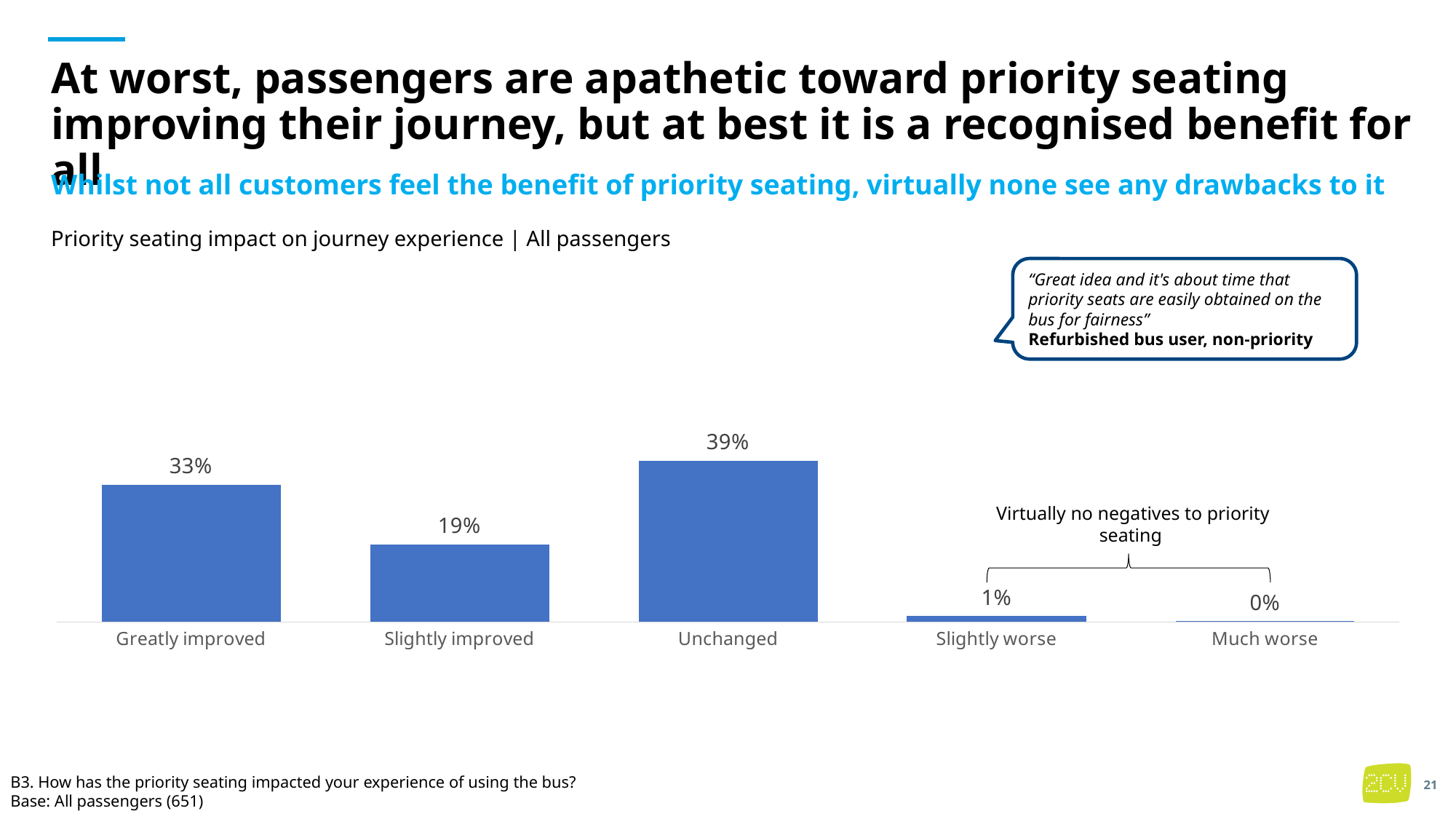
What is the combined value of Greatly improved and Slightly improved? 52% What percentage of passengers said their journey experience was greatly improved by priority seating? 33% What is the value for Slightly worse? 1% Which is larger, Greatly improved or Slightly improved? Greatly improved Which category has the lowest value? Much worse Which category has the highest value? Unchanged What is the value for Slightly improved? 19% What kind of chart is shown on the slide? Bar chart What is the value for Unchanged? 39% What is the difference between the Unchanged and Greatly improved values? 6% How many categories are shown on the x axis? 5 What is the value for Much worse? 0%